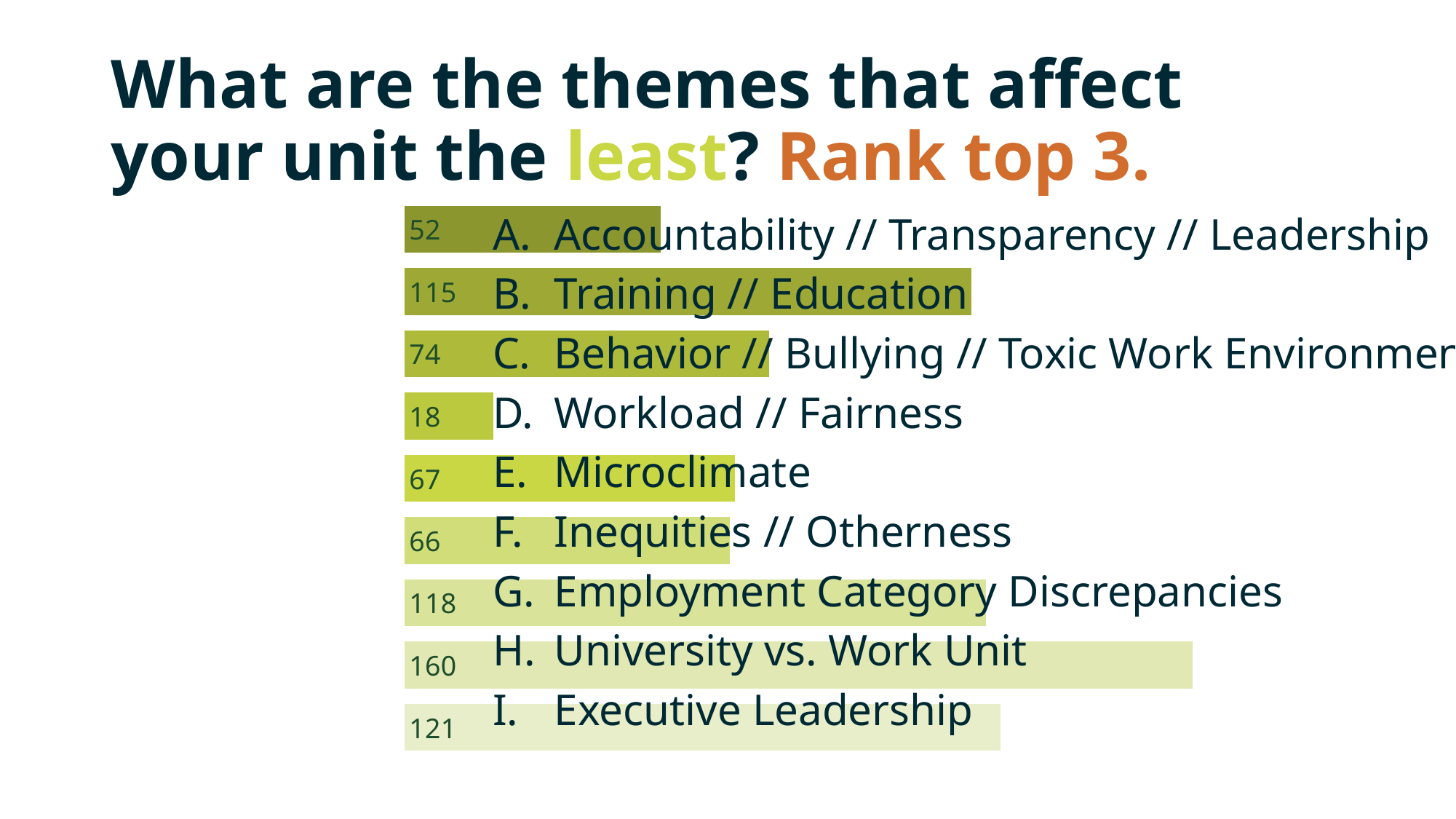
Which has a larger value, A. Accountability // Transparency // Leadership or F. Inequities // Otherness? F. Inequities // Otherness What is the value for D. Workload // Fairness? 18 What is the value for H. University vs. Work Unit? 160 Which has a larger value, B. Training // Education or C. Behavior // Bullying? B. Training // Education What kind of chart is shown on the slide? bar chart What is the value for E. Microclimate? 67 What is the difference between the values for H. University vs. Work Unit and D. Workload // Fairness? 142 Which theme has the lowest value? D. Workload // Fairness What is the value for B. Training // Education? 115 What is the difference between the values for I. Executive Leadership and G. Employment Category Discrepancies? 3 Which theme has the highest value? H. University vs. Work Unit How many categories (themes) are plotted in the chart? 9